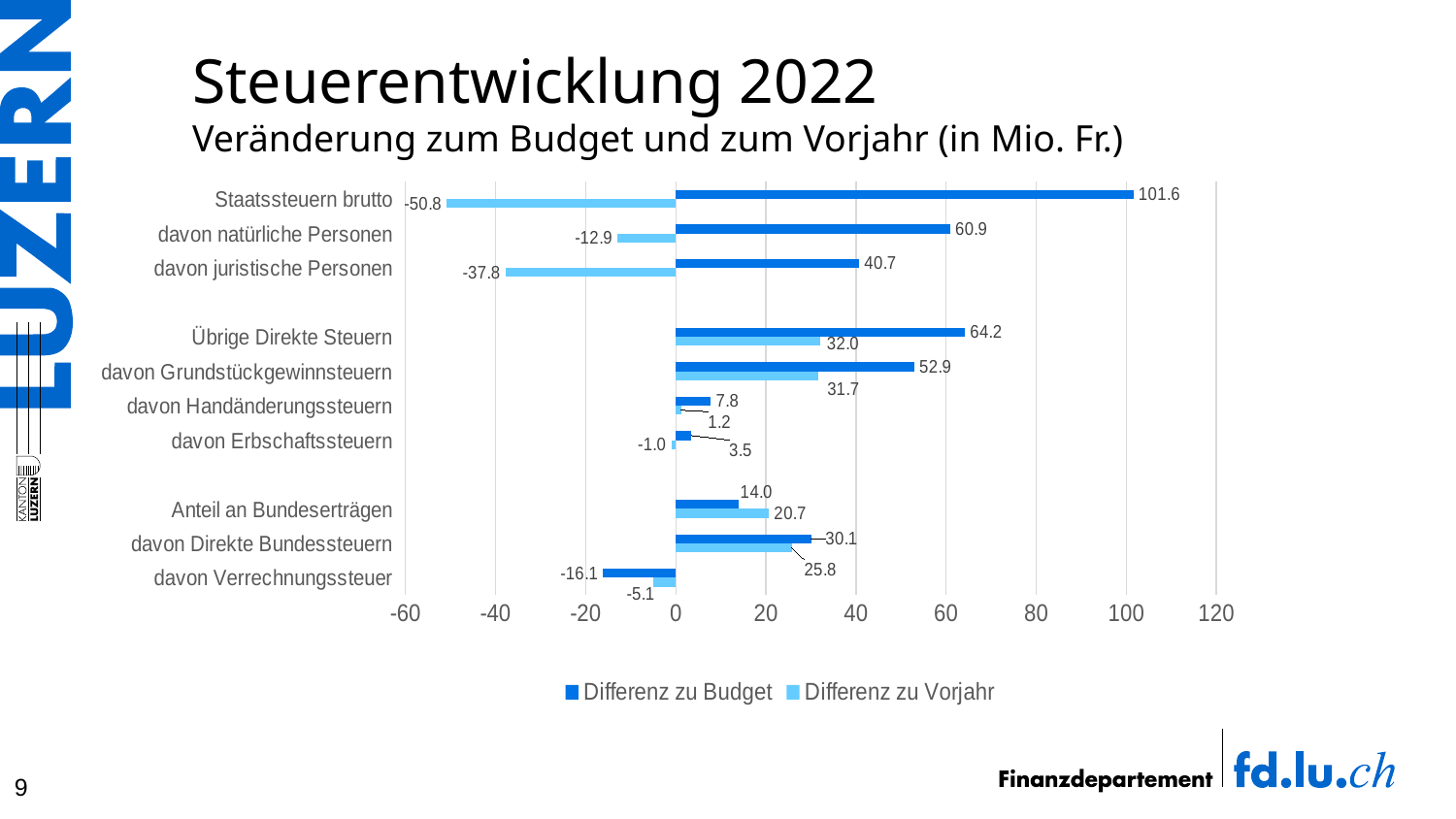
What unit is stated in the chart subtitle? Mio. Fr. What is the difference between the Differenz zu Budget values for davon natürliche Personen and davon juristische Personen? 20.2 How many series does the legend list? 2 What is the Differenz zu Budget value for davon Verrechnungssteuer? -16.1 Which category has the highest Differenz zu Budget value? Staatssteuern brutto Which category has the lowest Differenz zu Vorjahr value? Staatssteuern brutto What is the Differenz zu Budget value for Staatssteuern brutto? 101.6 Which is larger for Übrige Direkte Steuern: Differenz zu Budget or Differenz zu Vorjahr? Differenz zu Budget How many categories are shown on the chart? 10 What is the Differenz zu Vorjahr value for Anteil an Bundeserträgen? 20.7 What is the Differenz zu Vorjahr value for davon juristische Personen? -37.8 What kind of chart is shown on the slide? Bar chart